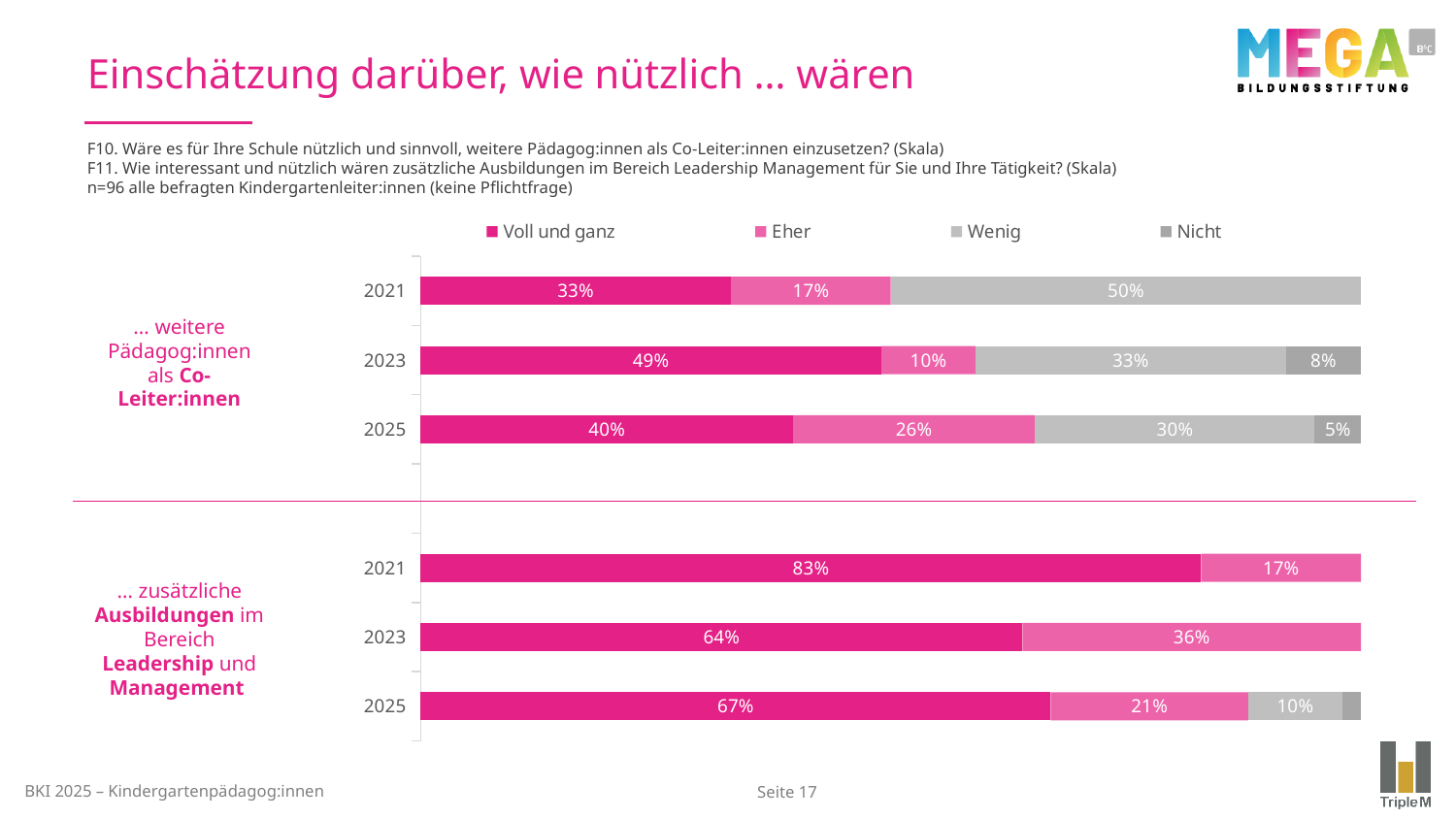
In the chart about weitere Pädagog:innen als Co-Leiter:innen, which year has the lowest 'Eher' value? 2023 How many years are shown in the chart about weitere Pädagog:innen als Co-Leiter:innen? 3 What kind of chart is used on this slide? Stacked bar chart In the chart about zusätzliche Ausbildungen im Bereich Leadership und Management, is the 'Voll und ganz' value larger in 2023 or in 2025? 2025 In the chart about weitere Pädagog:innen als Co-Leiter:innen, what is the 'Voll und ganz' value for 2023? 49% In the chart about weitere Pädagog:innen als Co-Leiter:innen, what is the difference between the 'Voll und ganz' values for 2023 and 2021? 16 percentage points Which legend entry is shown in the darkest pink colour? Voll und ganz In the chart about zusätzliche Ausbildungen im Bereich Leadership und Management, what is the 'Eher' value for 2023? 36% In the chart about weitere Pädagog:innen als Co-Leiter:innen, what is the total of the 2023 bar? 100% How many series does the legend list? 4 In the chart about zusätzliche Ausbildungen im Bereich Leadership und Management, which year has the highest 'Voll und ganz' value? 2021 In the chart about weitere Pädagog:innen als Co-Leiter:innen, what is the 'Wenig' value for 2021? 50%